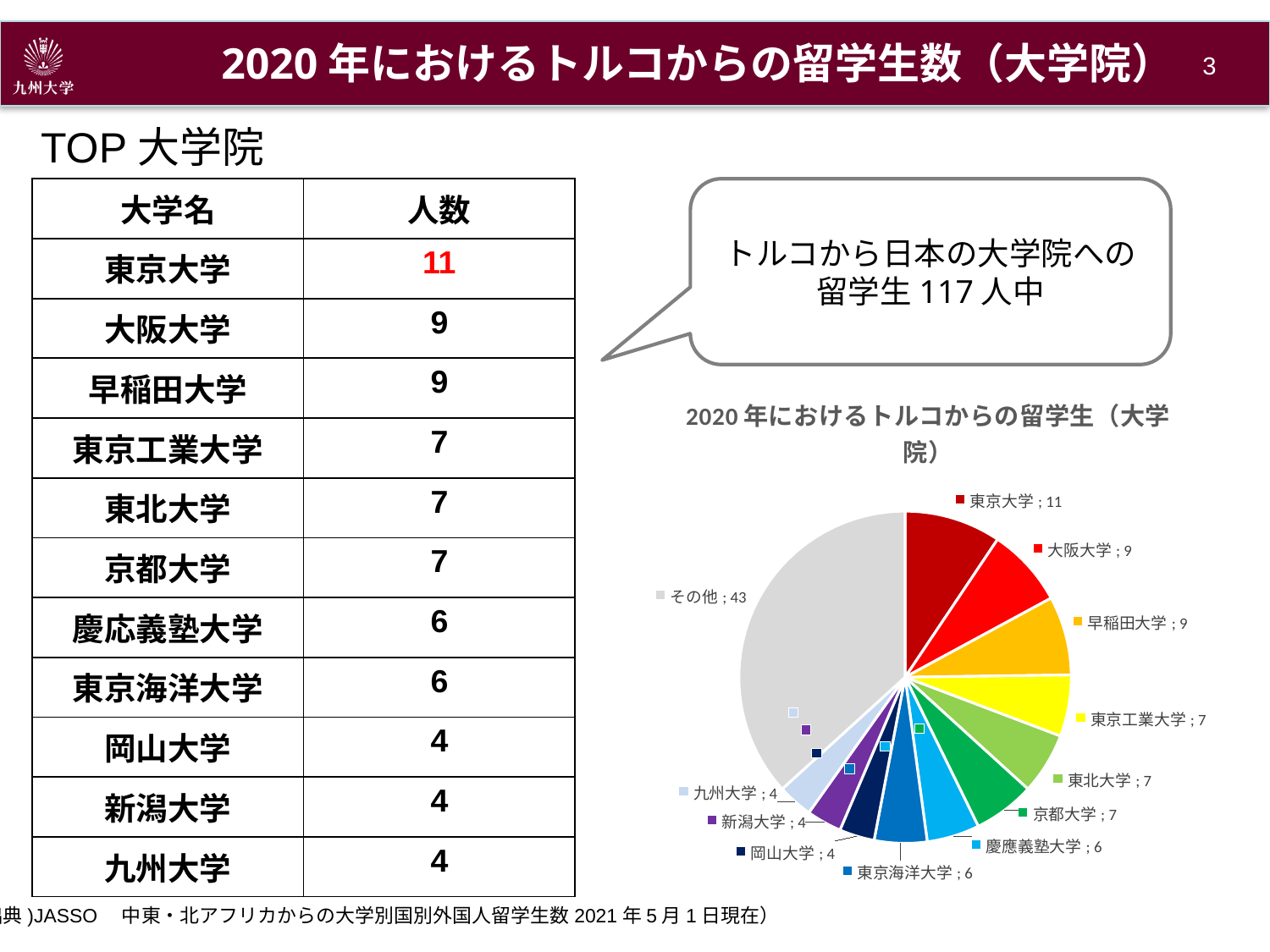
Which slice of the pie chart is the largest? その他 How many slices does the pie chart have? 12 What is the difference between the values for 東京大学 and 大阪大学 in the pie chart? 2 What is the difference between the values for その他 and 東京大学 in the pie chart? 32 In the pie chart, which is larger, the value for 東北大学 or the value for 東京海洋大学? 東北大学 In the pie chart, what is the value for その他? 43 In the pie chart, what is the value for 九州大学? 4 In the pie chart, what is the value for 慶應義塾大学? 6 In the pie chart, what is the value for 東京大学? 11 What is the title of the pie chart? 2020年におけるトルコからの留学生（大学院） What kind of chart is shown on the slide? pie chart Excluding その他, which university has the largest slice in the pie chart? 東京大学